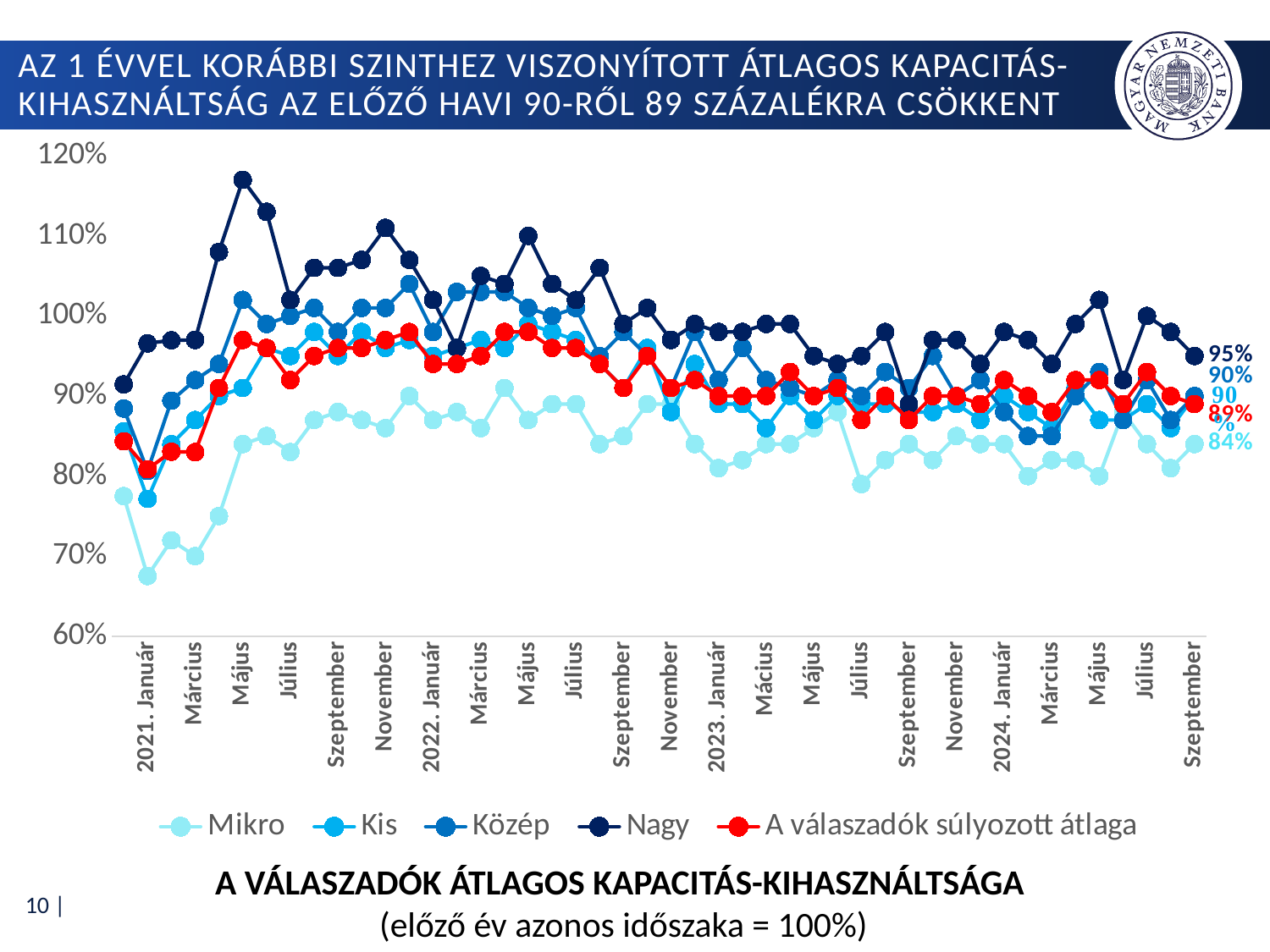
What is the latest value labelled for 'A válaszadók súlyozott átlaga'? 89% Which series is drawn in red in the legend? A válaszadók súlyozott átlaga Does the Nagy series rise or fall between 2021. Január and 2021. Május? rise What is the latest (Szeptember 2024) value labelled for the Nagy series? 95% Which series has the highest value at the last data point (Szeptember 2024)? Nagy What kind of chart is shown on the slide? line chart Is the Nagy value for 2021. Május greater or less than 110%? greater At the last data point, which is larger: the Nagy value or the Mikro value? Nagy What is the difference between the latest labelled values of Nagy (95%) and Mikro (84%)? 11 percentage points Which series has the lowest value at the last data point (Szeptember 2024)? Mikro What is the latest value labelled for the Mikro series? 84% How many series does the legend list? 5